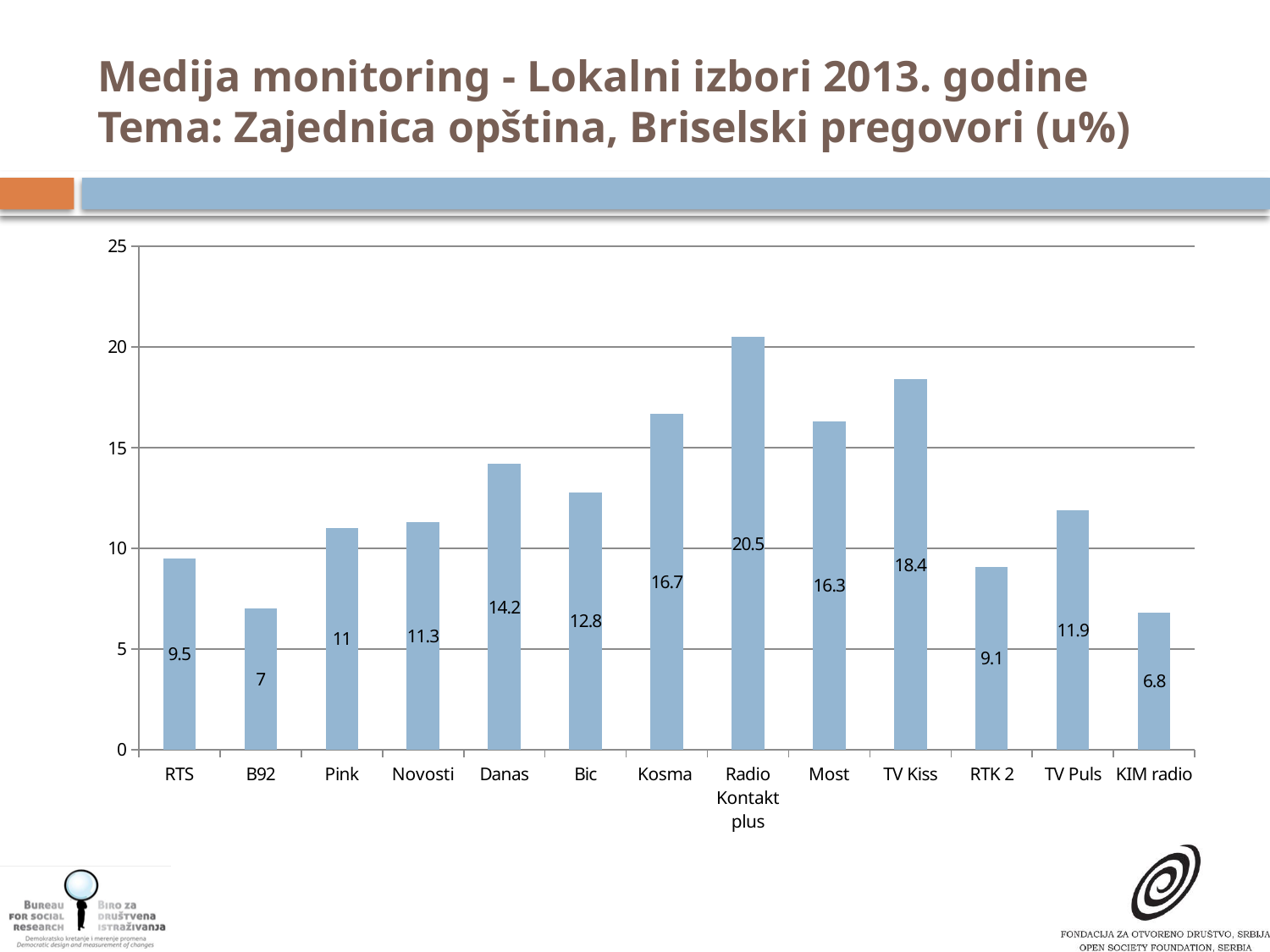
What is the value for Radio Kontakt plus? 20.5 Which is larger, the value for Danas or the value for Bic? Danas What kind of chart is shown on the slide? bar chart What is the maximum value shown on the y axis? 25 What is the difference between the values for RTS and RTK 2? 0.4 What is the difference between the values for TV Kiss and Most? 2.1 What is the value for TV Puls? 11.9 Which category has the lowest value? KIM radio Which category has the highest value? Radio Kontakt plus What is the value for B92? 7 How many categories are shown on the x axis? 13 Is the value for Kosma greater or less than 15? greater